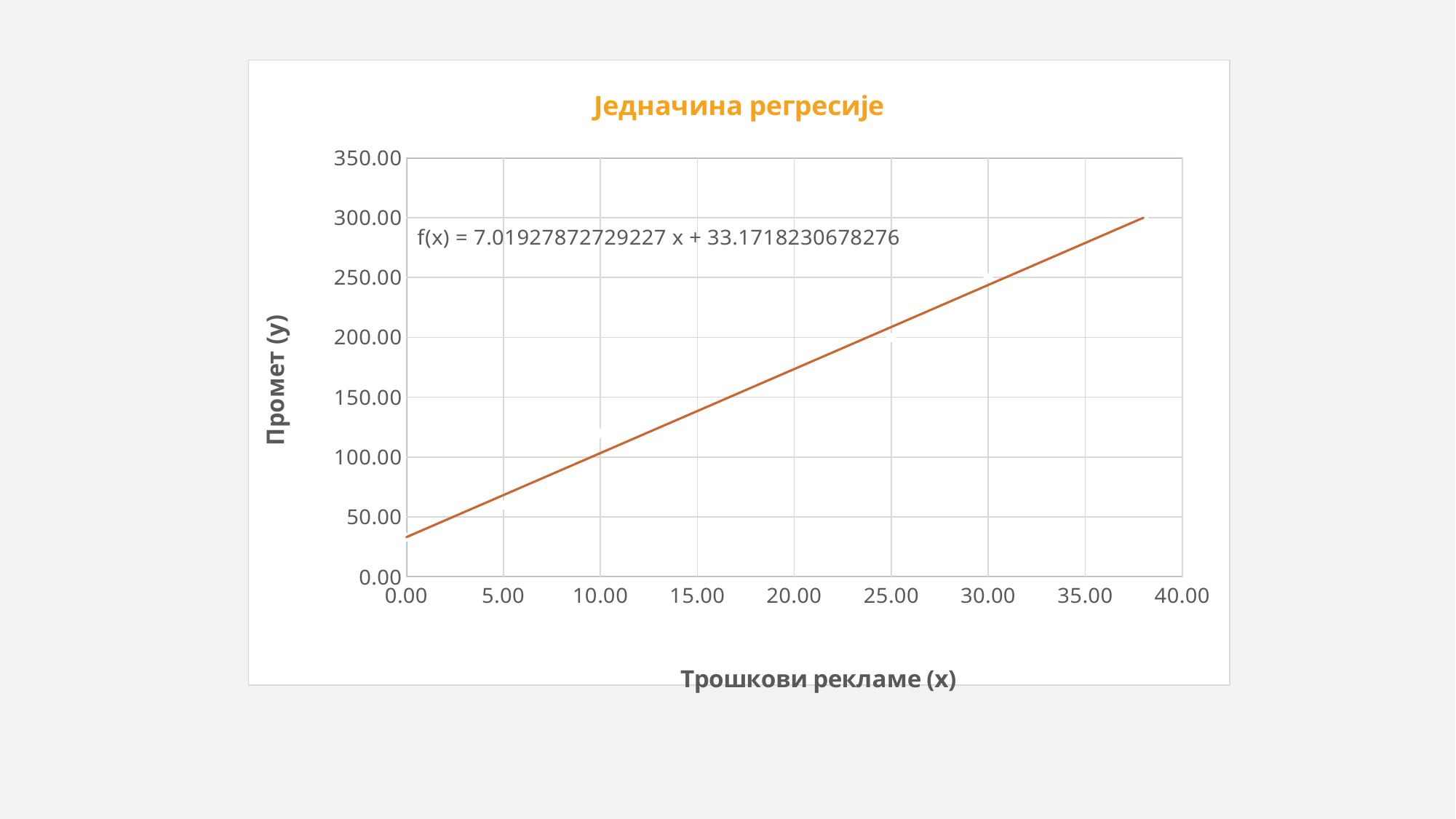
Is the value of the line at x = 30.00 greater or less than 200.00? greater What is the intercept (constant term) in the regression equation printed on the chart? 33.1718230678276 What is the slope (coefficient of x) in the regression equation printed on the chart? 7.01927872729227 What is the highest tick value shown on the y axis? 350.00 Does the plotted line rise or fall as x increases? rises What is the label of the x axis? Трошкови рекламе (x) Is the value of the line at x = 5.00 greater or less than 50.00? greater What kind of chart is shown on the slide? line chart Is the value of the line at x = 0.00 greater or less than 50.00? less What is the title of the chart? Једначина регресије